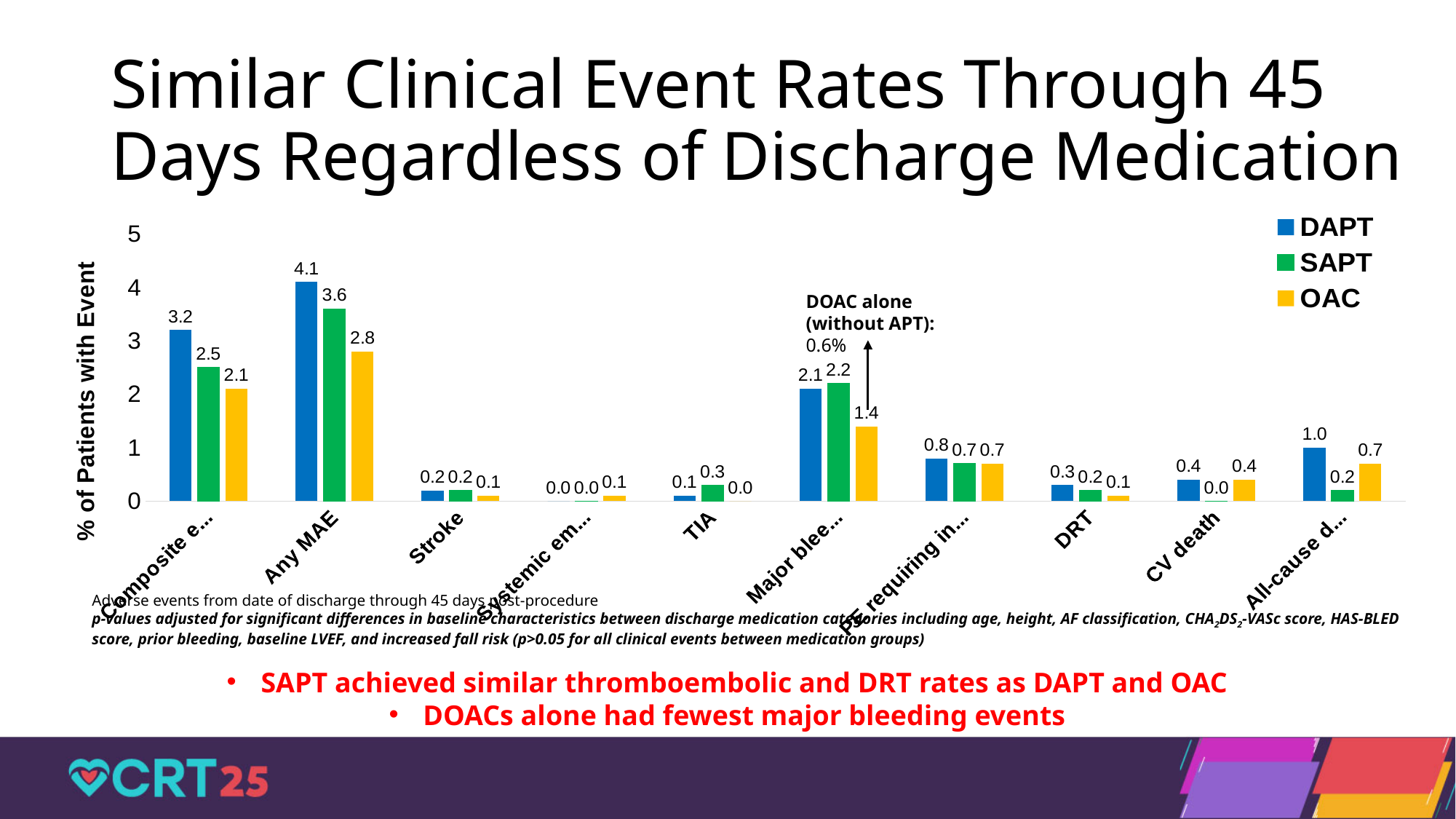
What is the OAC value for Any MAE? 2.8 What kind of chart is shown on the slide? Bar chart What is the difference between the DAPT and SAPT values for Any MAE? 0.5 How many categories are shown on the x axis? 10 What is the DAPT value for DRT? 0.3 How many series does the legend list? 3 What is the SAPT value for CV death? 0.0 Which category has the highest DAPT value? Any MAE What is the DAPT value for Any MAE? 4.1 What is the SAPT value for TIA? 0.3 For Stroke, which is larger, the DAPT value or the OAC value? DAPT What is the label of the y axis? % of Patients with Event